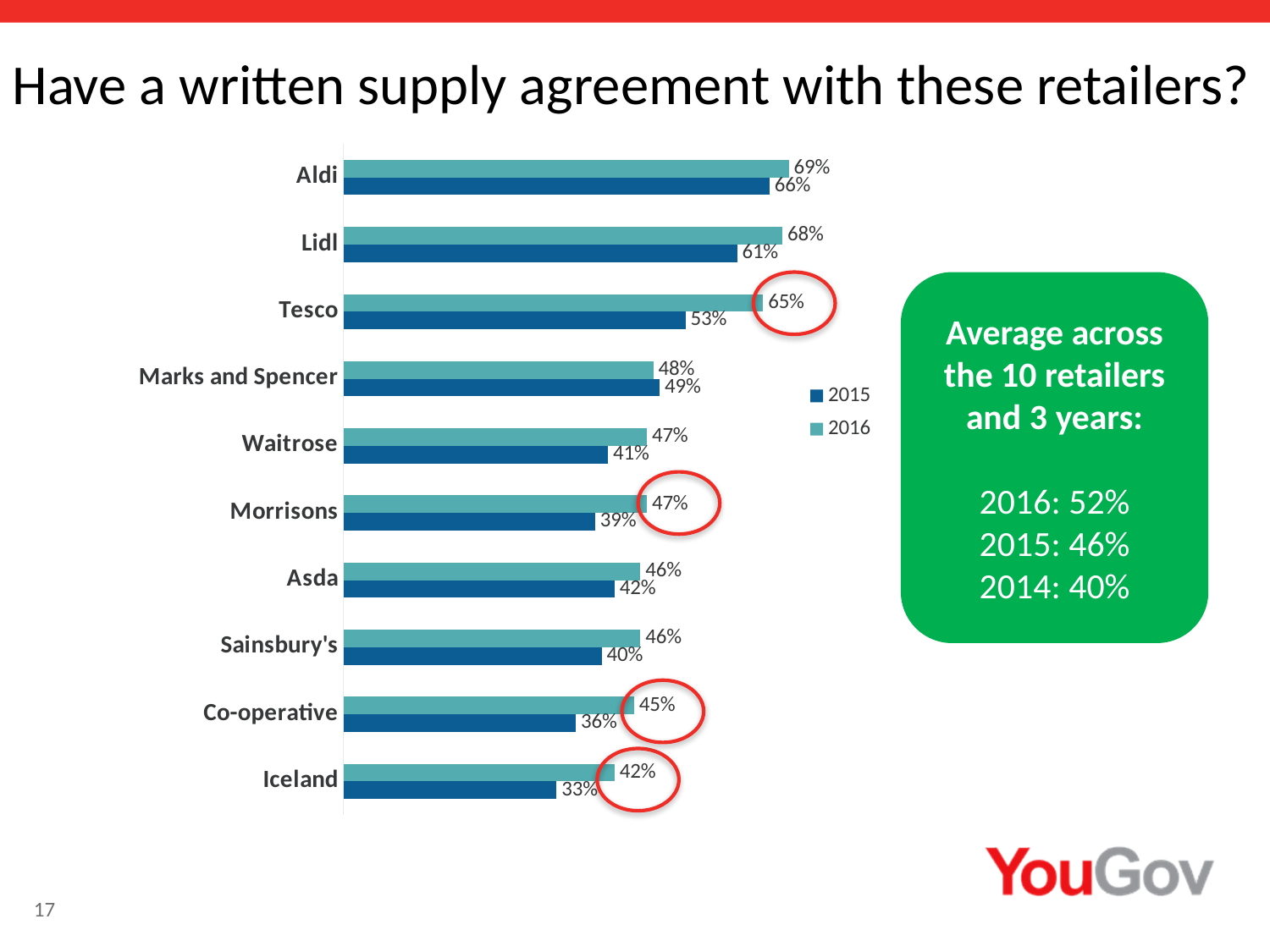
What is the 2016 value for Tesco? 65% How many series does the legend list? 2 What is the 2015 value for Iceland? 33% What is the 2015 value for Waitrose? 41% Which is larger, the 2015 value for Lidl or the 2015 value for Tesco? Lidl What is the difference between the 2016 values for Aldi and Lidl? 1% What is the difference between the 2016 and 2015 values for Tesco? 12% Which retailer has the highest 2016 value? Aldi Which retailer has the lowest 2015 value? Iceland What kind of chart is shown on the slide? Bar chart Which is larger for Marks and Spencer, the 2015 value or the 2016 value? 2015 How many retailers are shown in the chart? 10